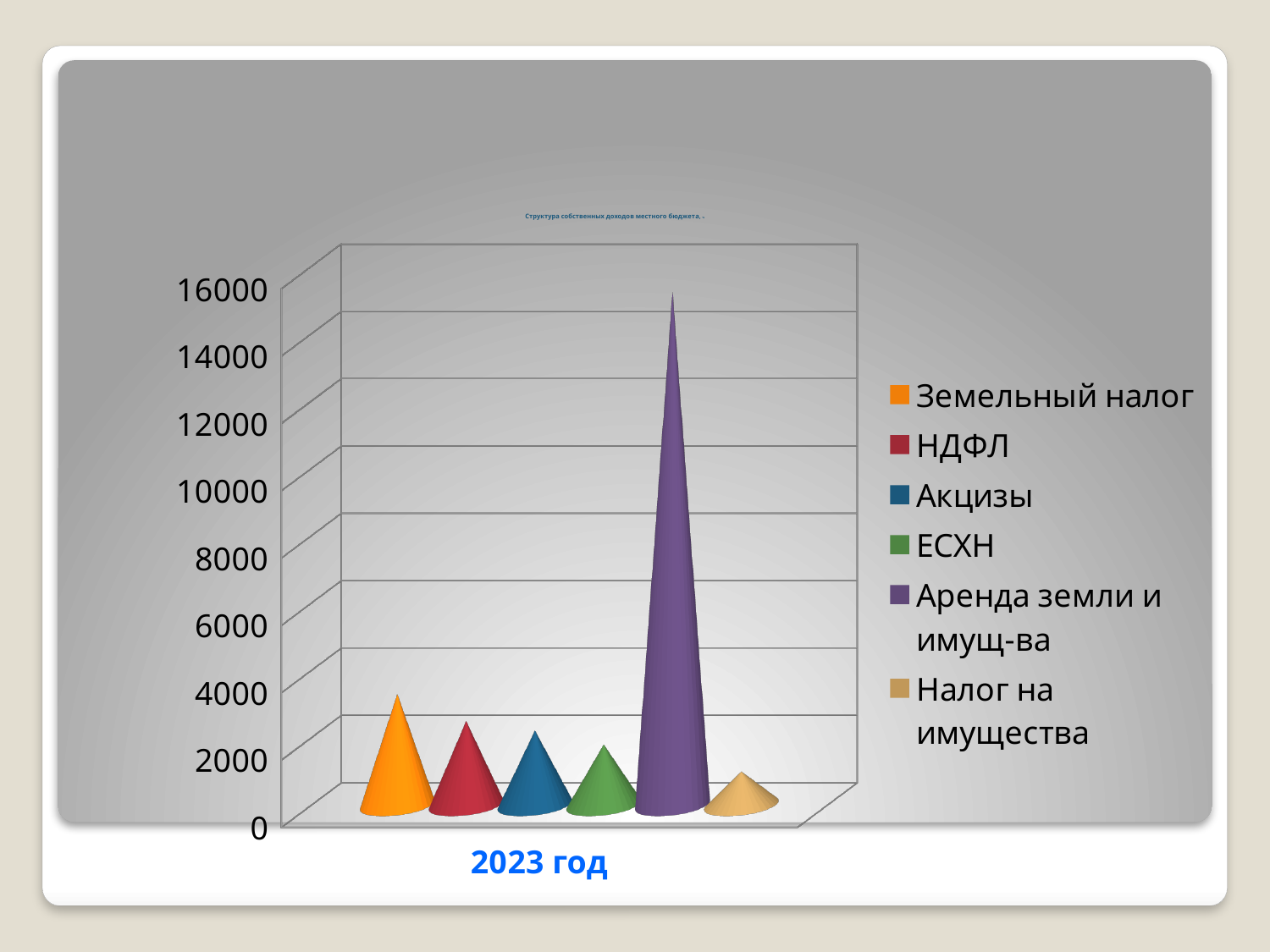
Which is larger, the value for Земельный налог or the value for Налог на имущества? Земельный налог Is the value for Налог на имущества greater or less than 2000? less How many categories are shown on the x axis? 1 How many series does the legend list? 6 Is the value for Земельный налог greater or less than 4000? less Which series has the highest value in 2023 год? Аренда земли и имущ-ва Is the value for Аренда земли и имущ-ва greater or less than 14000? greater What kind of chart is shown on the slide? bar chart Which series has the lowest value in 2023 год? Налог на имущества Which is larger, the value for Аренда земли и имущ-ва or the value for Акцизы? Аренда земли и имущ-ва What is the category label shown on the x axis? 2023 год